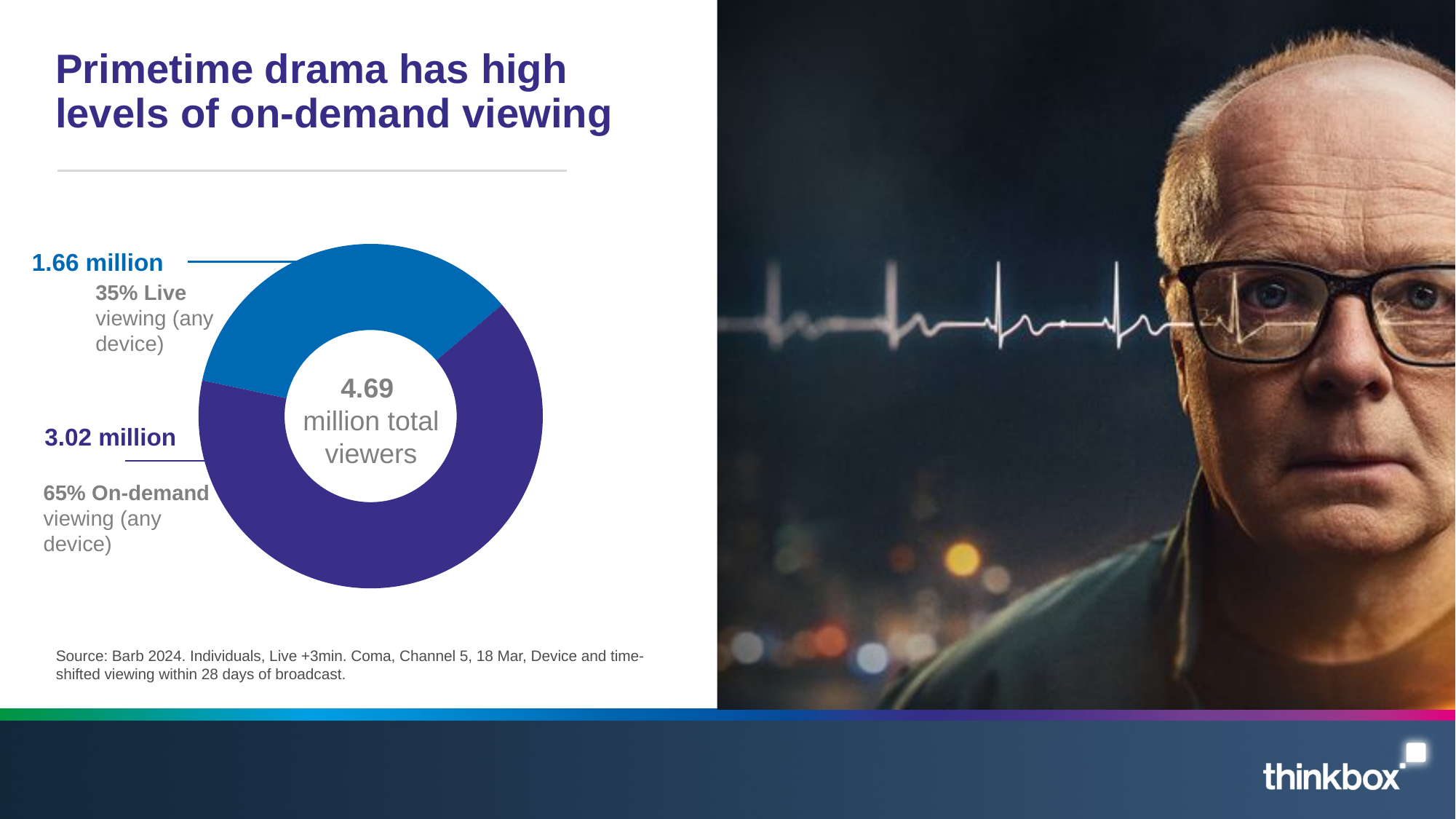
What is the total number of viewers shown in the centre of the chart? 4.69 million total viewers What is the title of the slide containing the chart? Primetime drama has high levels of on-demand viewing How many segments does the doughnut chart have? 2 What share of viewing is live viewing (any device)? 35% Which segment of the chart is the smallest? Live viewing (any device) What share of viewing is on-demand viewing (any device)? 65% What colour is the on-demand viewing segment of the chart? Purple What is the difference in viewers between on-demand viewing and live viewing? 1.36 million What kind of chart is shown on the slide? Doughnut (pie) chart How many viewers does the chart show for on-demand viewing (any device)? 3.02 million How many viewers does the chart show for live viewing (any device)? 1.66 million Which segment is larger, live viewing or on-demand viewing? On-demand viewing